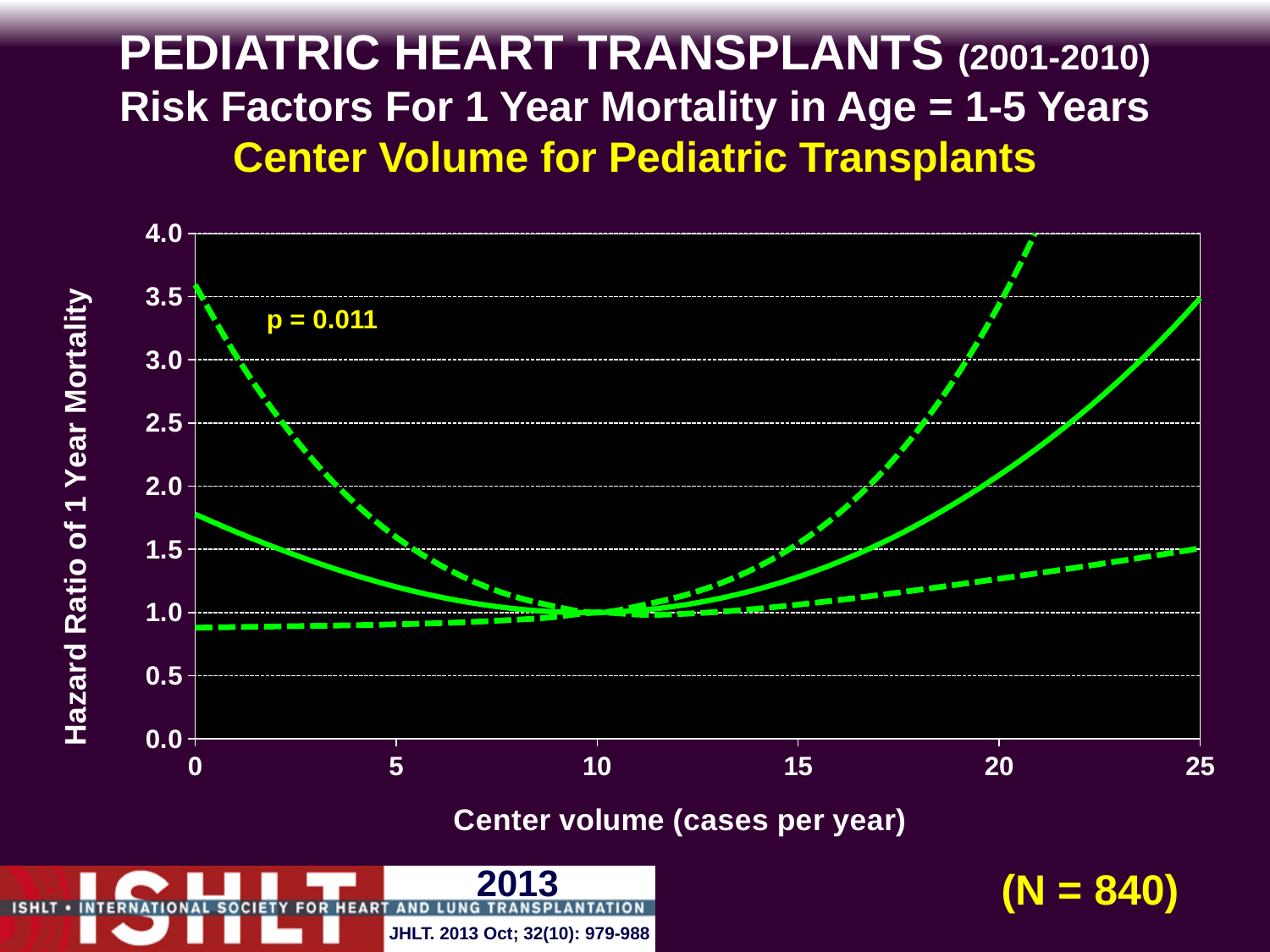
Which is larger for the solid line: the hazard ratio at a center volume of 0 or at a center volume of 25? 25 What is the hazard ratio of the solid line at a center volume of 10 cases per year? 1.0 Is the hazard ratio of the upper dashed line at a center volume of 0 greater or less than 3.0? greater What is the label of the x axis? Center volume (cases per year) Is the hazard ratio of the solid line at a center volume of 25 greater or less than 3.0? greater What is the label of the y axis? Hazard Ratio of 1 Year Mortality Is the hazard ratio of the lower dashed line at a center volume of 0 greater or less than 1.0? less How many curves are plotted on the chart? 3 Does the solid line rise or fall as center volume increases from 10 to 25 cases per year? rise What kind of chart is shown on the slide? line chart What p-value is printed on the chart? p = 0.011